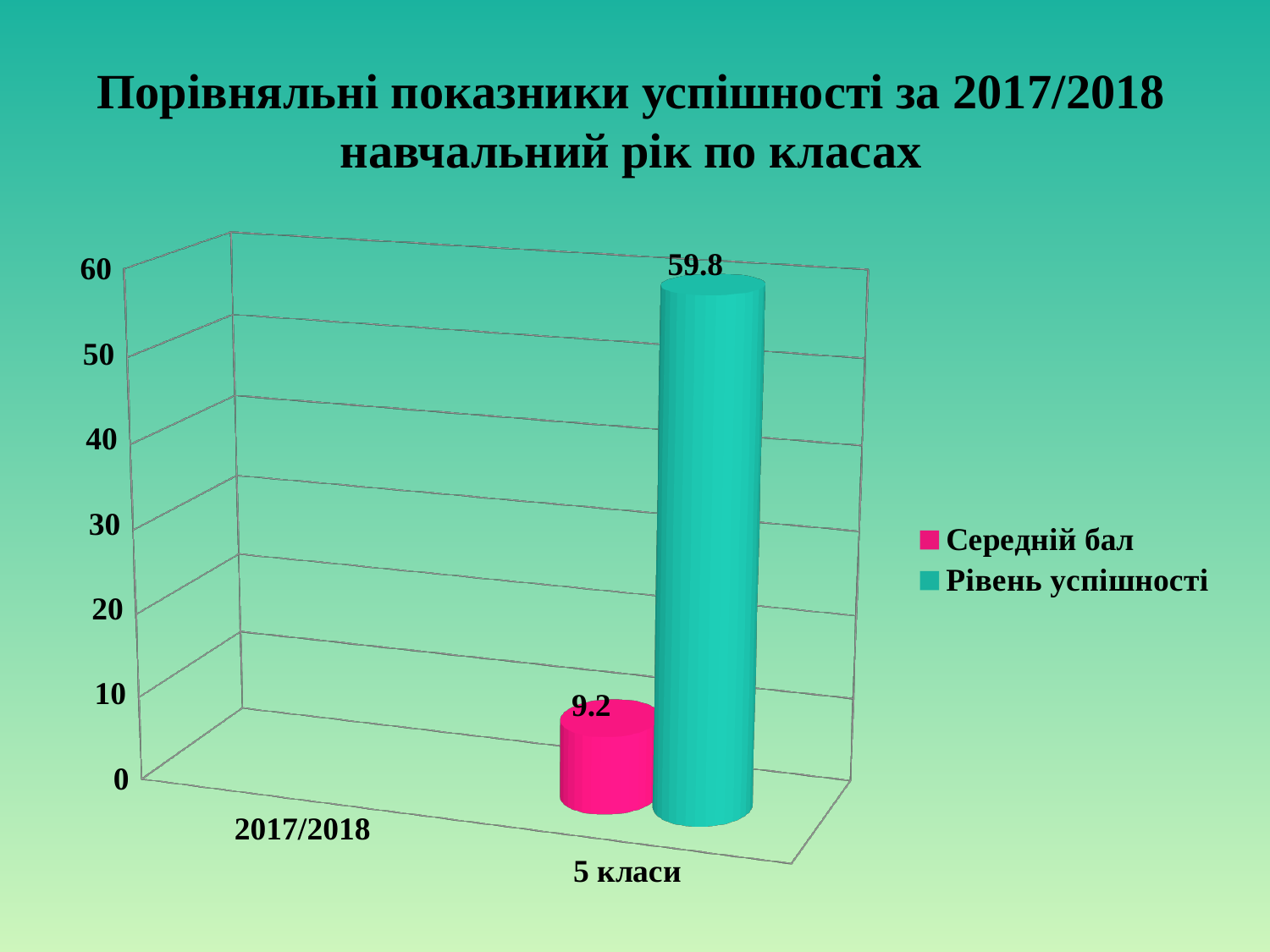
What is the value of Середній бал for 5 класи? 9.2 What is the title of the chart on the slide? Порівняльні показники успішності за 2017/2018 навчальний рік по класах Is the value of Середній бал for 5 класи greater or less than 10? less Which series has the higher value for 5 класи, Середній бал or Рівень успішності? Рівень успішності How many series does the legend list? 2 How many categories are shown on the x axis? 2 What is the value of Рівень успішності for 5 класи? 59.8 What kind of chart is shown on the slide? Bar chart Which colour represents Середній бал in the legend? Pink Is the value of Рівень успішності for 5 класи greater or less than 50? greater What is the highest value shown on the vertical axis? 60 What is the difference between Рівень успішності and Середній бал for 5 класи? 50.6